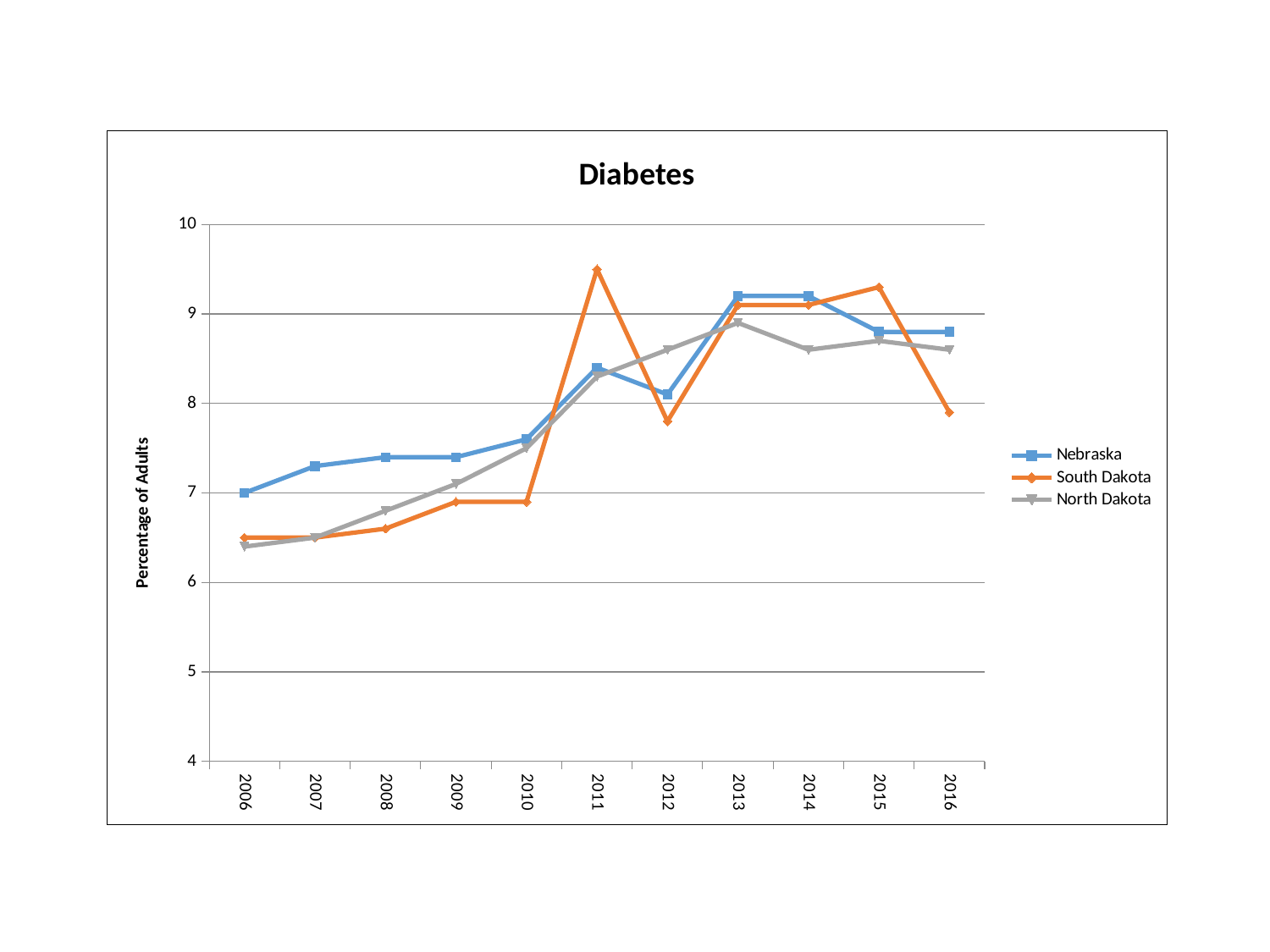
What kind of chart is shown on the slide? line chart Is the value for South Dakota in 2011 greater or less than 9? greater How many series does the legend list? 3 What is the label on the vertical axis? Percentage of Adults Is the value for North Dakota in 2006 greater or less than 7? less Which series has the highest value in 2011? South Dakota How many years are shown on the x axis? 11 Is the value for Nebraska in 2013 greater or less than 9? greater What is the title of the chart? Diabetes Which series has the lowest value in 2016? South Dakota Does the Nebraska line rise or fall from 2006 to 2011? rise In 2015, which is higher, Nebraska or South Dakota? South Dakota